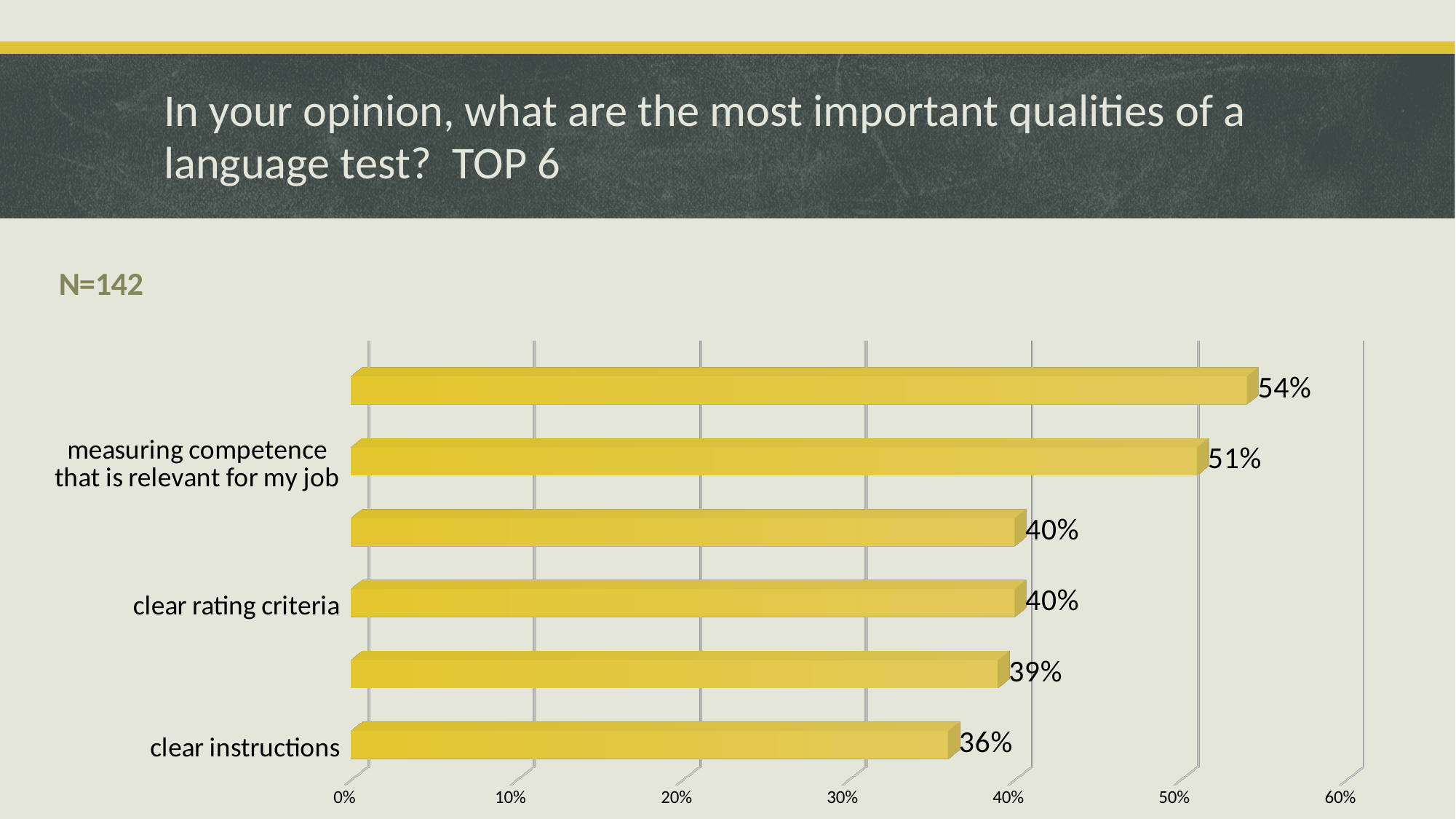
What is the difference between the values for "measuring competence that is relevant for my job" and "clear instructions"? 15 percentage points Is the value for "clear instructions" greater or less than 40%? less What is the value for "clear rating criteria"? 40% What sample size (N) is stated on the slide? N=142 Is the value for "measuring competence that is relevant for my job" greater or less than 50%? greater Which is larger, the value for "clear rating criteria" or the value for "clear instructions"? clear rating criteria What kind of chart is shown on the slide? bar chart What is the value for "measuring competence that is relevant for my job"? 51% How many bars are shown on the chart? 6 Which labelled category has the lowest value? clear instructions What is the value for "clear instructions"? 36% What is the highest value shown on the chart? 54%